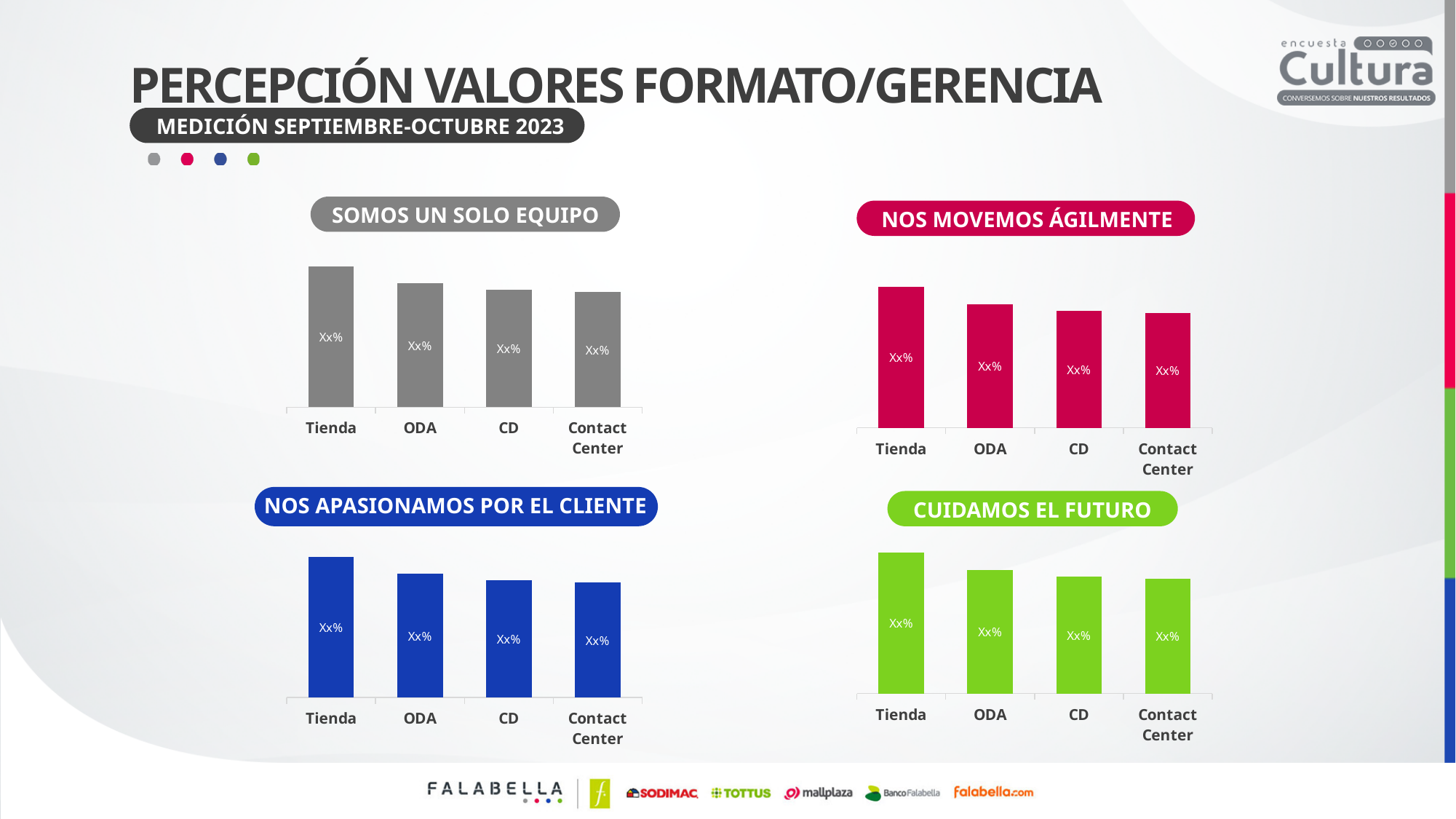
In the 'SOMOS UN SOLO EQUIPO' chart, which category has the tallest bar? Tienda How many categories are shown in the 'NOS MOVEMOS ÁGILMENTE' chart? 4 In the 'NOS APASIONAMOS POR EL CLIENTE' chart, which is larger, the bar for ODA or the bar for Contact Center? ODA In the 'CUIDAMOS EL FUTURO' chart, which category has the highest value? Tienda What colour are the bars in the 'NOS APASIONAMOS POR EL CLIENTE' chart? Blue What is the title of the chart with green bars? CUIDAMOS EL FUTURO Do the bar heights in the 'SOMOS UN SOLO EQUIPO' chart rise or fall from Tienda to Contact Center? Fall In the 'NOS MOVEMOS ÁGILMENTE' chart, which category has the highest value? Tienda In the 'CUIDAMOS EL FUTURO' chart, which is larger, the bar for Tienda or the bar for ODA? Tienda How many bar charts are shown on the slide? 4 What kind of chart is used under the heading 'SOMOS UN SOLO EQUIPO'? Bar chart